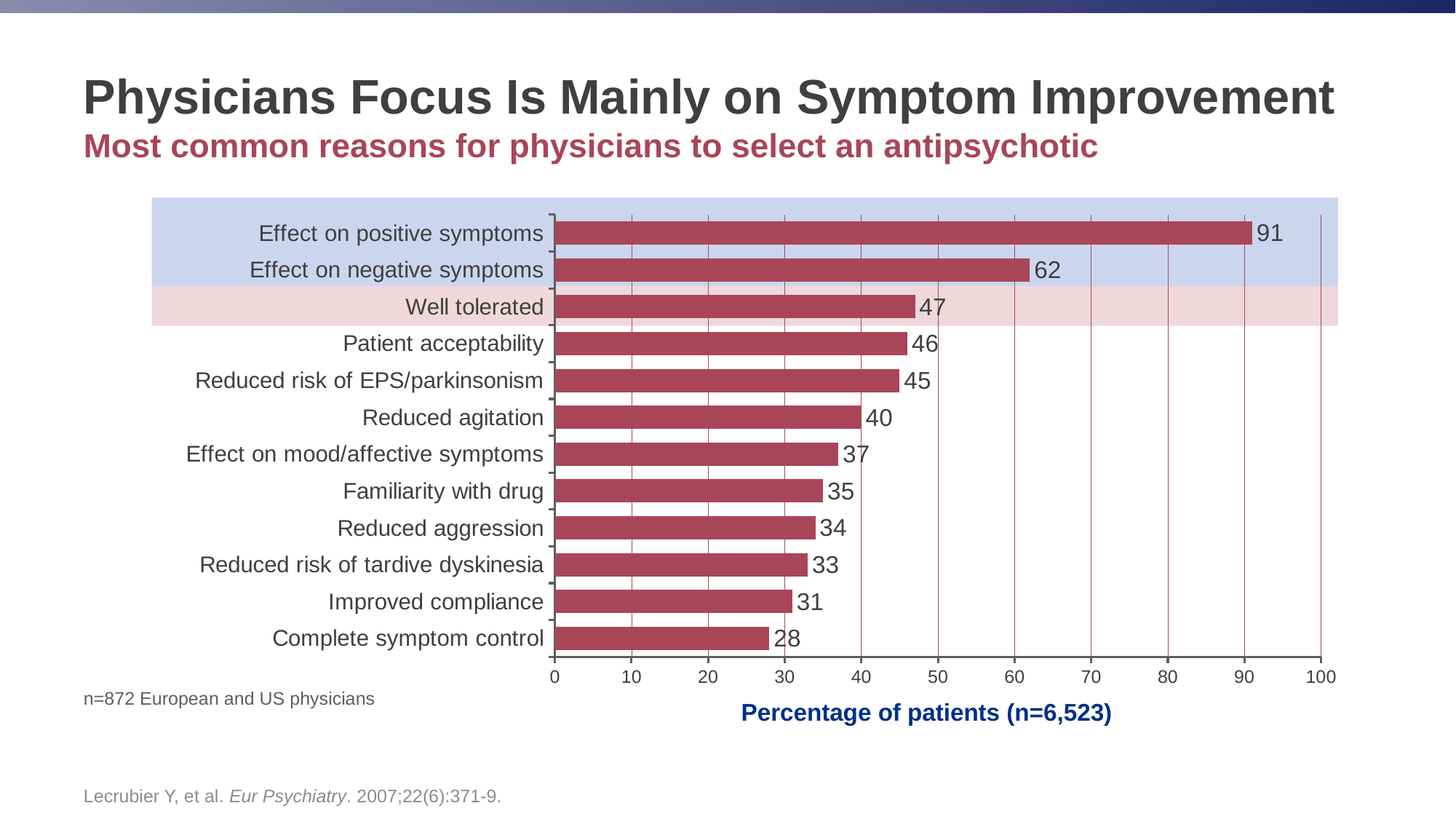
How many reasons are shown in the chart? 12 What is the difference between Effect on positive symptoms and Effect on negative symptoms? 29 What is the value for Effect on positive symptoms? 91 What is the x-axis label of the chart? Percentage of patients (n=6,523) Which reason has the lowest value? Complete symptom control Which reason has the highest value? Effect on positive symptoms What is the value for Reduced agitation? 40 What is the value for Improved compliance? 31 What is the difference between Well tolerated and Complete symptom control? 19 What kind of chart is shown on the slide? bar chart Is the value for Effect on mood/affective symptoms greater or less than 40? less Which is larger, Familiarity with drug or Reduced risk of tardive dyskinesia? Familiarity with drug